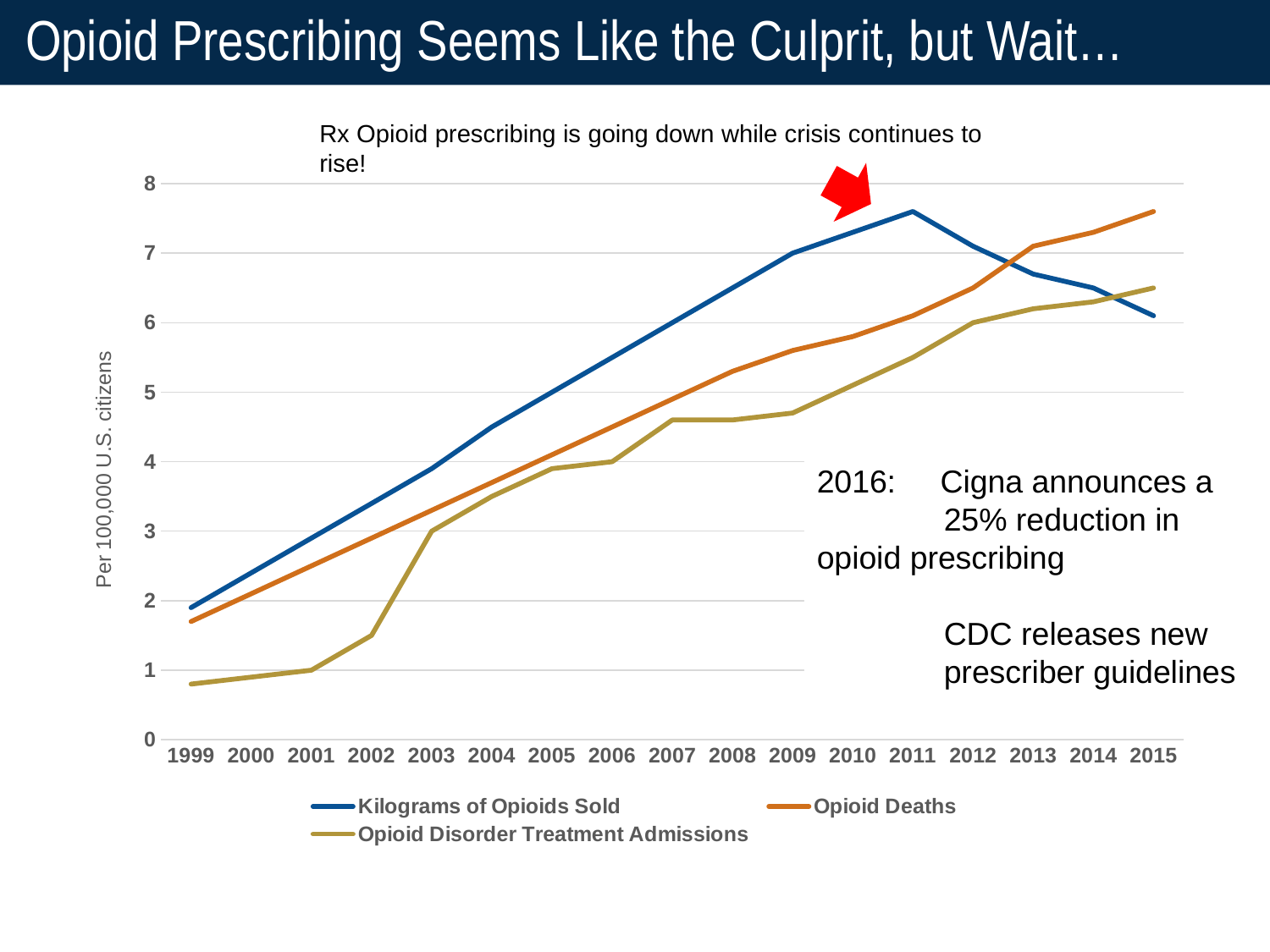
In 2015, which is larger: Opioid Deaths or Kilograms of Opioids Sold? Opioid Deaths In which year does the Kilograms of Opioids Sold line reach its highest point? 2011 Which series has the lowest value in 1999? Opioid Disorder Treatment Admissions What kind of chart is shown on the slide? line chart How many years are shown on the x axis? 17 Is the value for Opioid Deaths in 2015 greater or less than 7? greater Is the value for Kilograms of Opioids Sold in 2011 greater or less than 7? greater What is the label on the vertical axis? Per 100,000 U.S. citizens How many series does the legend list? 3 Is the value for Opioid Disorder Treatment Admissions in 1999 greater or less than 1? less Does the Kilograms of Opioids Sold line rise or fall from 2011 to 2015? fall In 2005, which is larger: Kilograms of Opioids Sold or Opioid Disorder Treatment Admissions? Kilograms of Opioids Sold